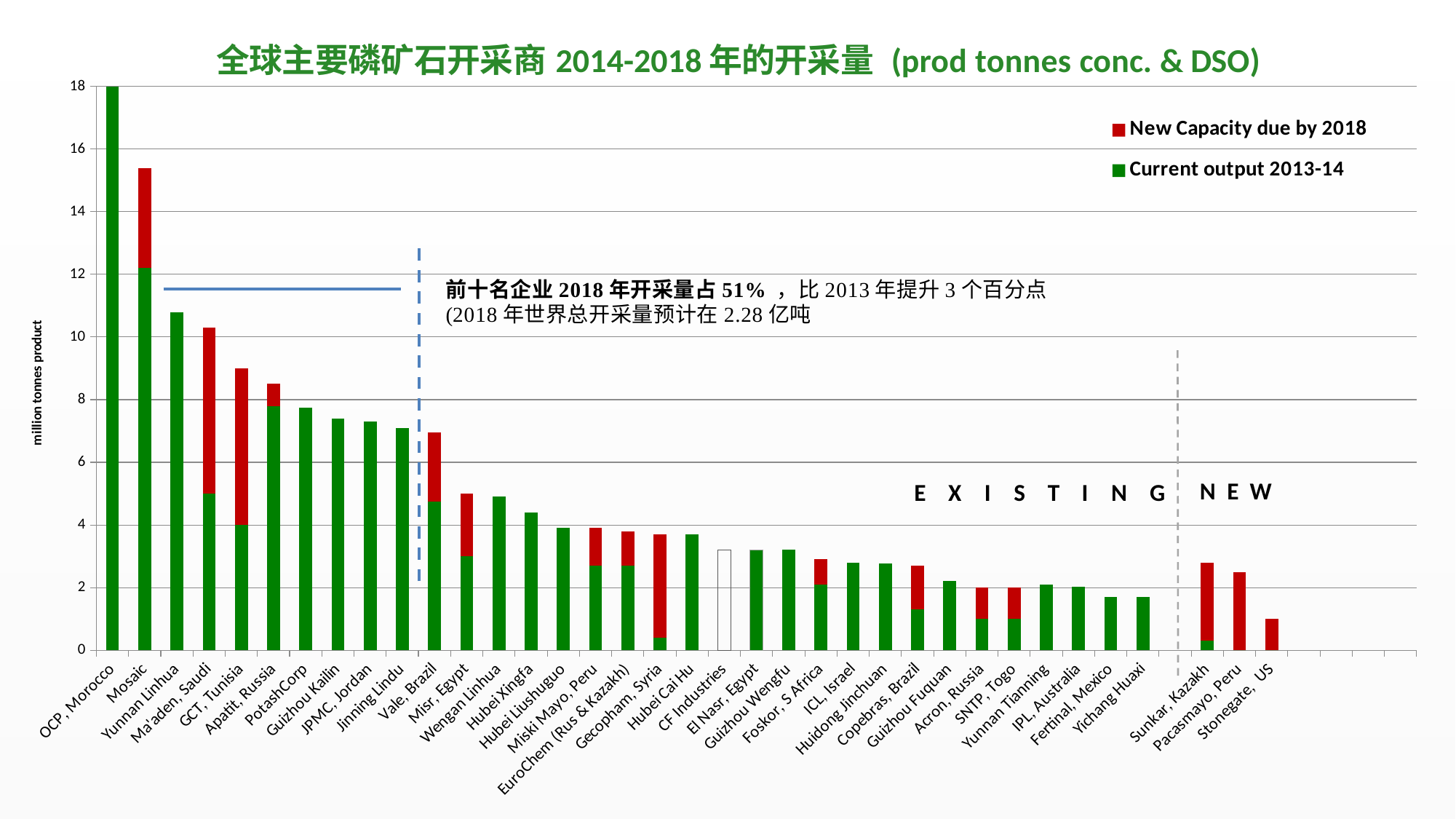
Which colour represents 'New Capacity due by 2018' in the legend? red How many producers (categories) are plotted along the x axis? 36 Which producer has the lowest total bar? Stonegate, US Is the total value for OCP, Morocco greater or less than 16? greater Is the total value for Stonegate, US greater or less than 2? less Which producer has the highest total bar? OCP, Morocco Is the total value for Mosaic greater or less than 14? greater Which has the larger total bar, Mosaic or Yunnan Linhua? Mosaic How many series does the legend list? 2 What is the label on the vertical axis? million tonnes product What kind of chart is shown on the slide? bar chart